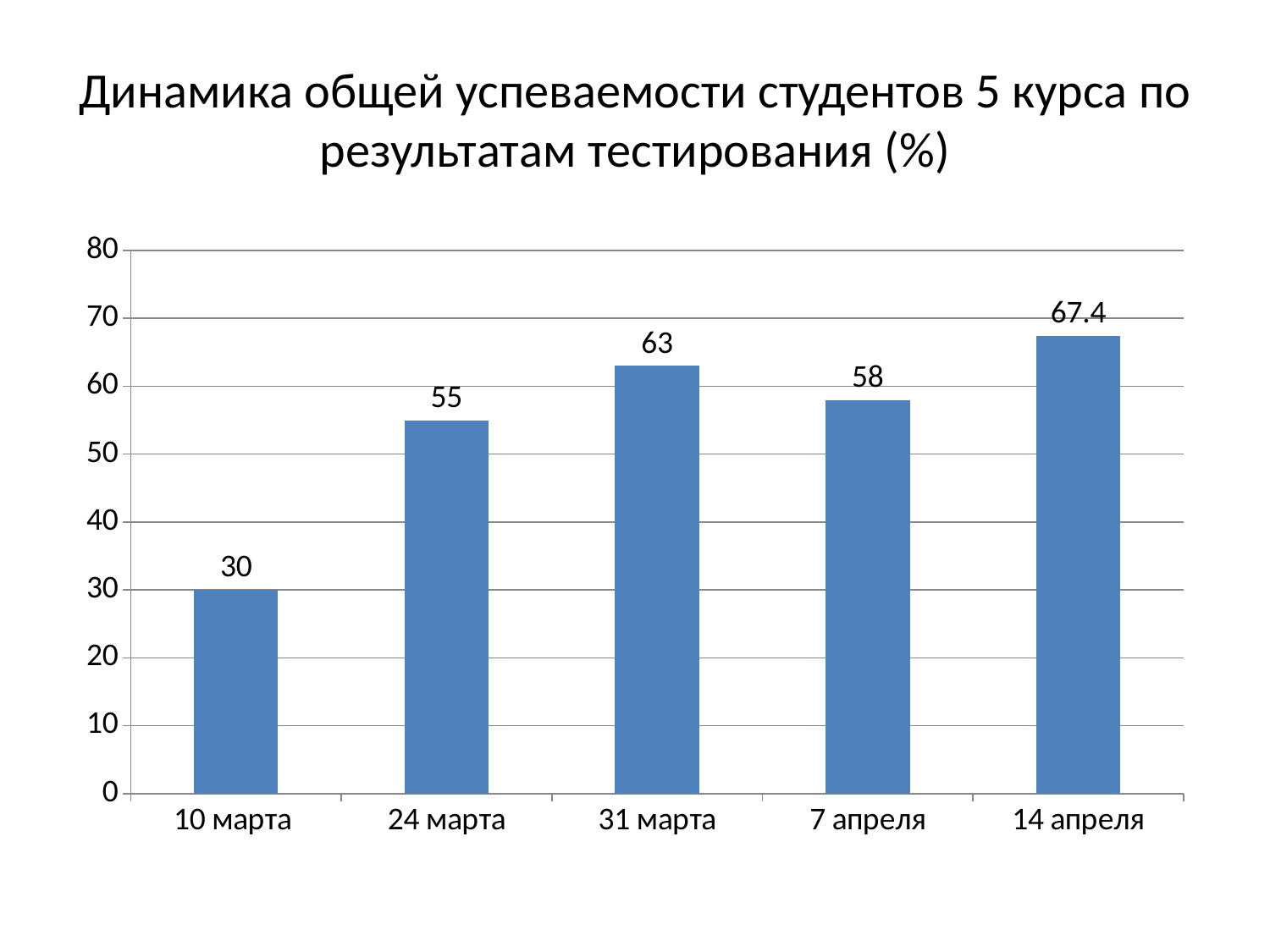
What is the value for 7 апреля? 58 What is the difference between the values for 31 марта and 24 марта? 8 What is the title of the chart? Динамика общей успеваемости студентов 5 курса по результатам тестирования (%) Which date has the lowest value? 10 марта What kind of chart is shown on the slide? bar chart Is the value for 24 марта greater or less than 50? greater Which is larger, the value for 31 марта or the value for 7 апреля? 31 марта What is the difference between the values for 14 апреля and 10 марта? 37.4 What is the value for 10 марта? 30 How many dates are shown on the x axis? 5 Which date has the highest value? 14 апреля What is the value for 14 апреля? 67.4